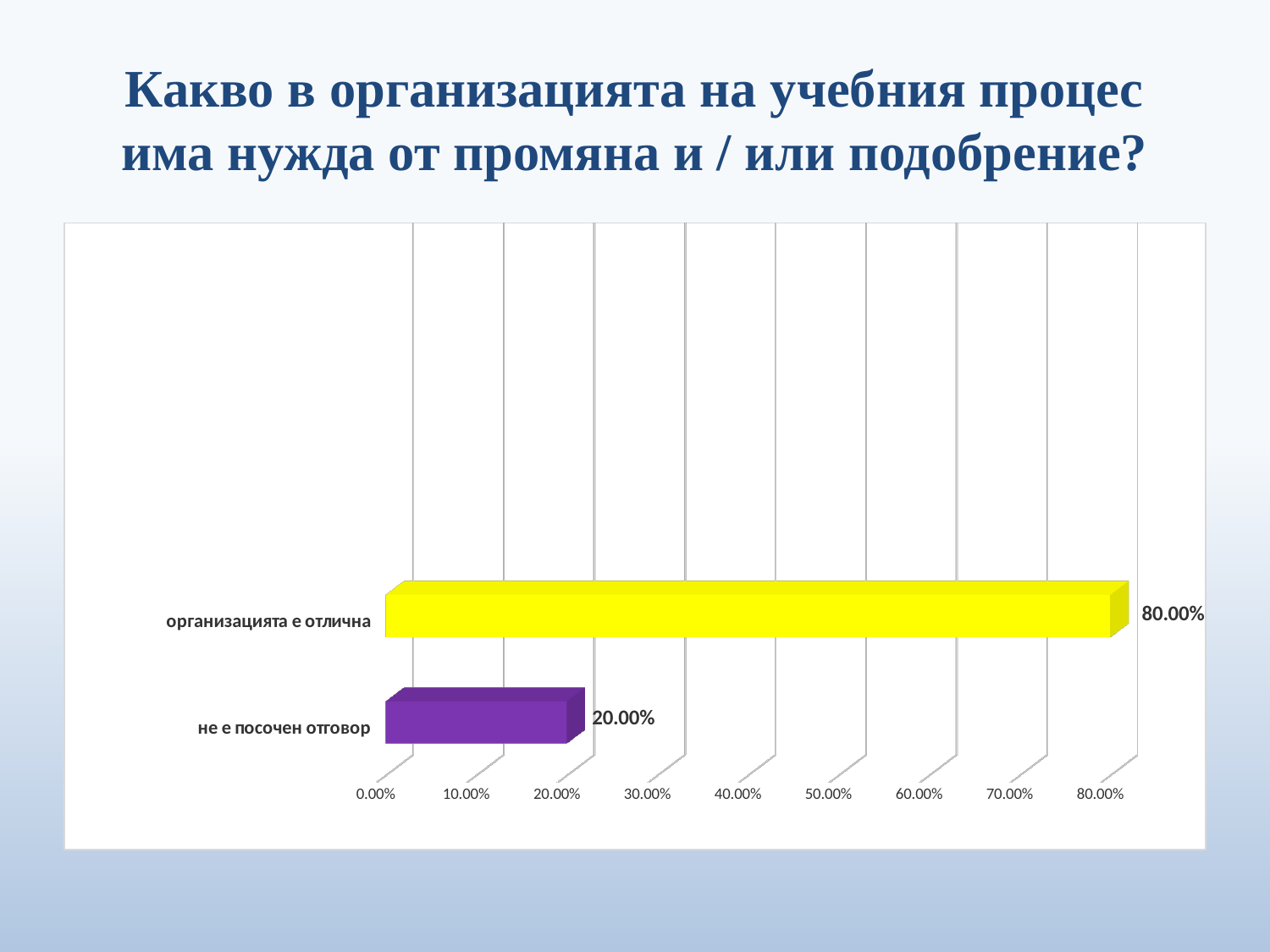
How many categories are shown in the chart? 2 Which category has the lowest value? не е посочен отговор What is the highest value shown on the x axis? 80.00% What is the value for "организацията е отлична"? 80.00% Is the value for "организацията е отлична" greater or less than 50.00%? greater What colour is the bar for "организацията е отлична"? yellow What is the value for "не е посочен отговор"? 20.00% Which is larger: the value for "организацията е отлична" or the value for "не е посочен отговор"? организацията е отлична Is the value for "не е посочен отговор" greater or less than 30.00%? less What kind of chart is shown on the slide? bar chart Which category has the highest value? организацията е отлична What is the difference between the values for "организацията е отлична" and "не е посочен отговор"? 60.00%